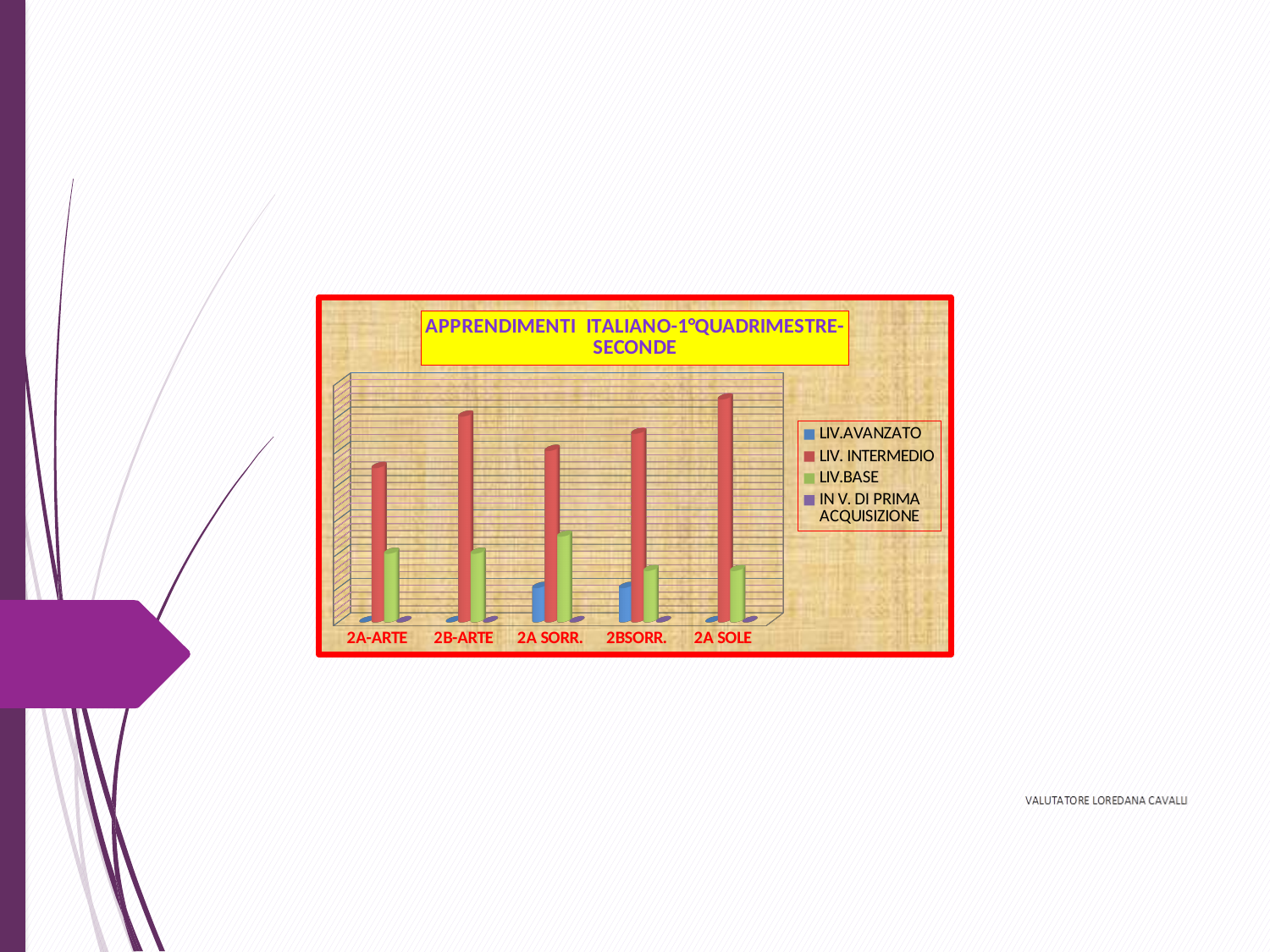
How many categories are shown along the x axis of the chart? 5 How many categories show a visible LIV.AVANZATO bar? 2 What kind of chart is shown on the slide? bar chart Which category has the highest LIV. INTERMEDIO bar? 2A SOLE Which is larger: the LIV. INTERMEDIO bar for 2B-ARTE or for 2A SORR.? 2B-ARTE Which is larger: the LIV.BASE bar for 2A SORR. or for 2BSORR.? 2A SORR. How many series does the chart legend list? 4 What is the title of the chart? APPRENDIMENTI ITALIANO-1°QUADRIMESTRE-SECONDE Which category has the lowest LIV. INTERMEDIO bar? 2A-ARTE In 2A SOLE, which is larger: LIV. INTERMEDIO or LIV.BASE? LIV. INTERMEDIO Which series is shown in red in the chart? LIV. INTERMEDIO Which category has the highest LIV.BASE bar? 2A SORR.